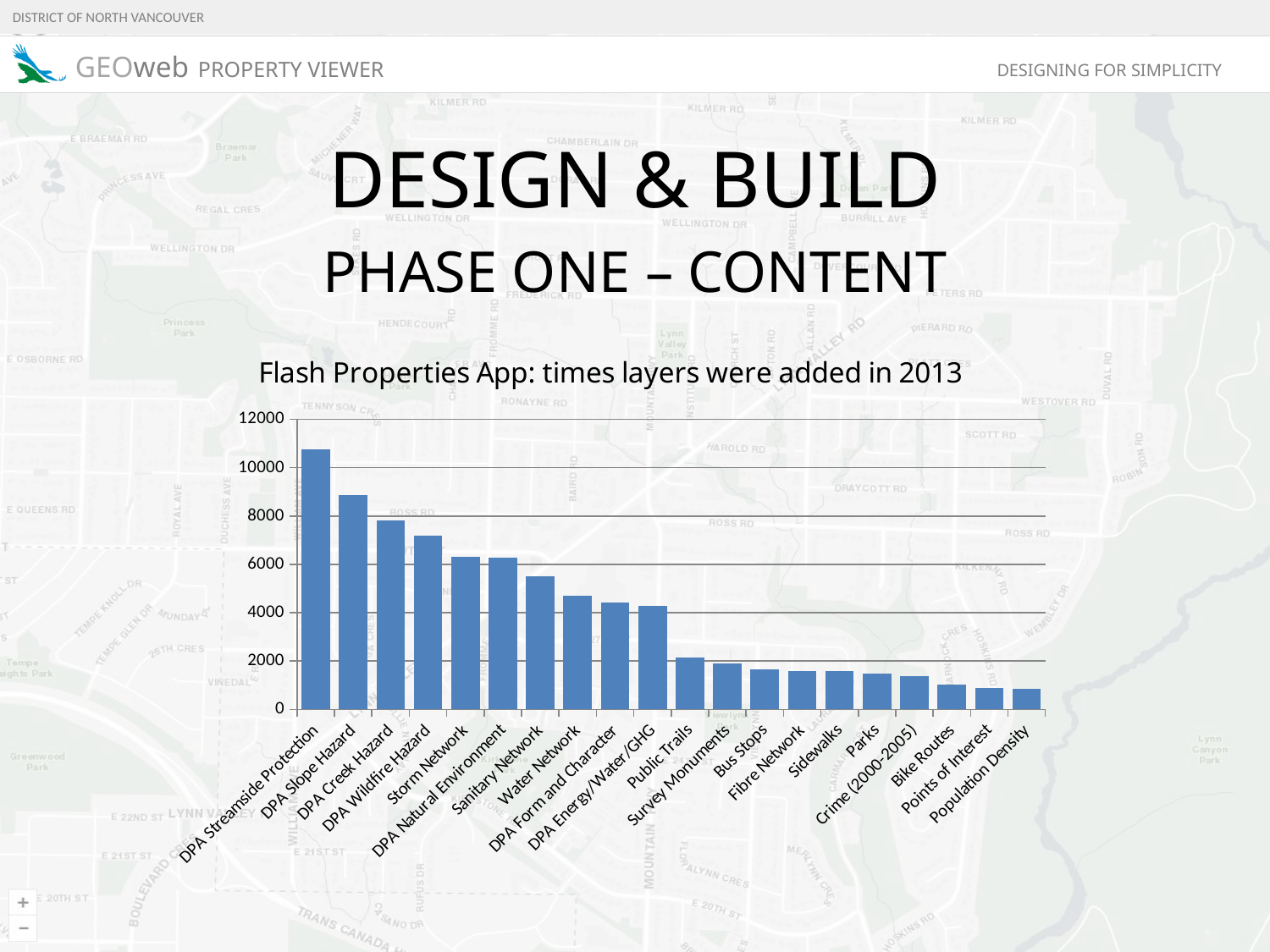
Which has a higher value, DPA Creek Hazard or Sanitary Network? DPA Creek Hazard Is the value for DPA Slope Hazard greater or less than 8000? greater Is the value for Public Trails greater or less than 4000? less What is the title of the chart? Flash Properties App: times layers were added in 2013 Do the values rise or fall moving from left to right along the x axis? fall Which layer was added the fewest times in 2013? Population Density Is the value for Water Network greater or less than 6000? less How many categories (layers) are plotted on the chart? 20 Which layer was added the most times in 2013? DPA Streamside Protection Which has a higher value, Bike Routes or Public Trails? Public Trails What kind of chart is shown on the slide? bar chart